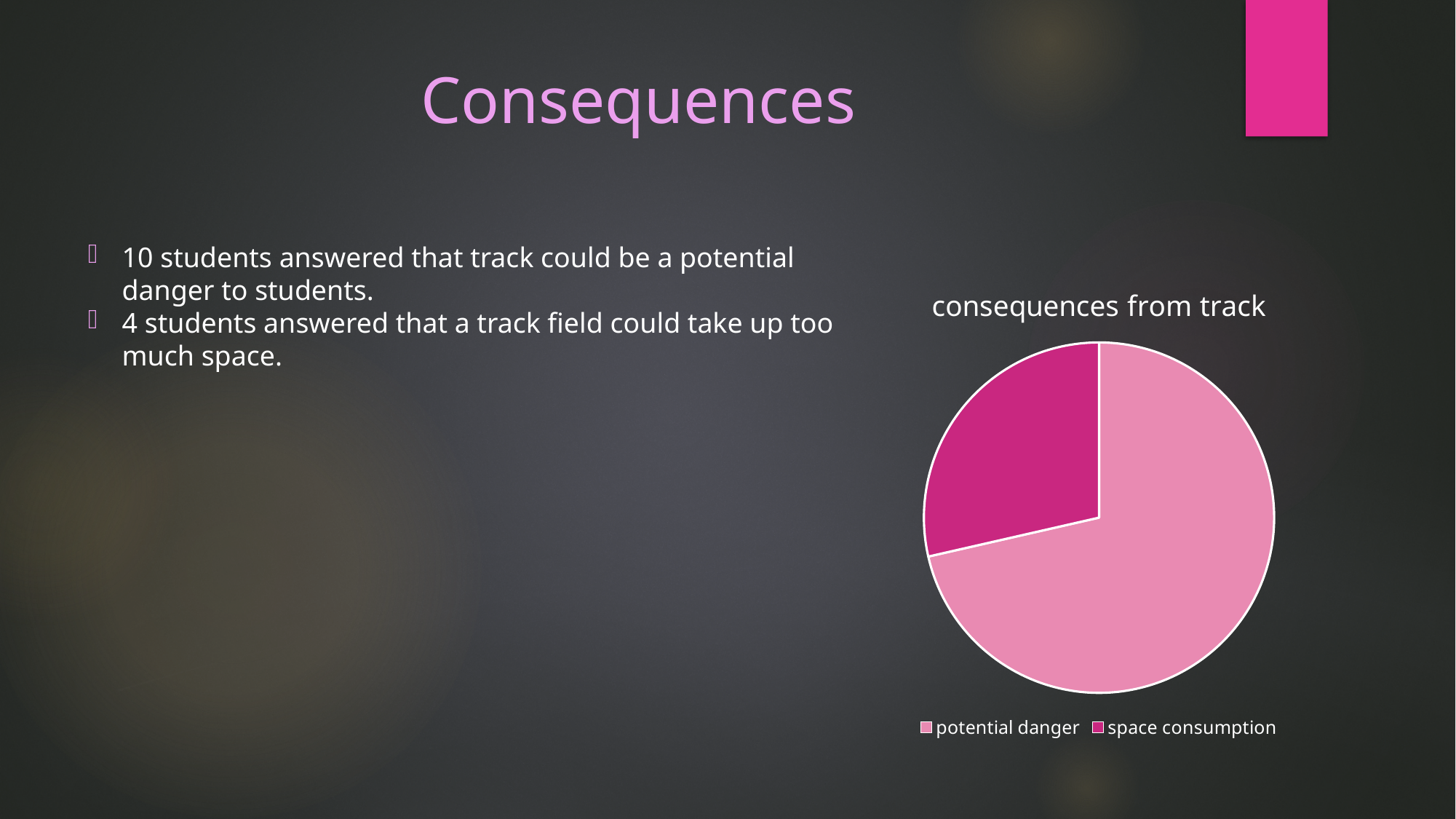
How many slices does the pie chart have? 2 Which category has the largest slice of the pie? potential danger Which slice is larger, potential danger or space consumption? potential danger What kind of chart is shown on the slide? pie chart What is the title of the chart? consequences from track Which legend entry is shown in the darker pink colour? space consumption How many entries does the chart legend list? 2 Which category has the smallest slice of the pie? space consumption